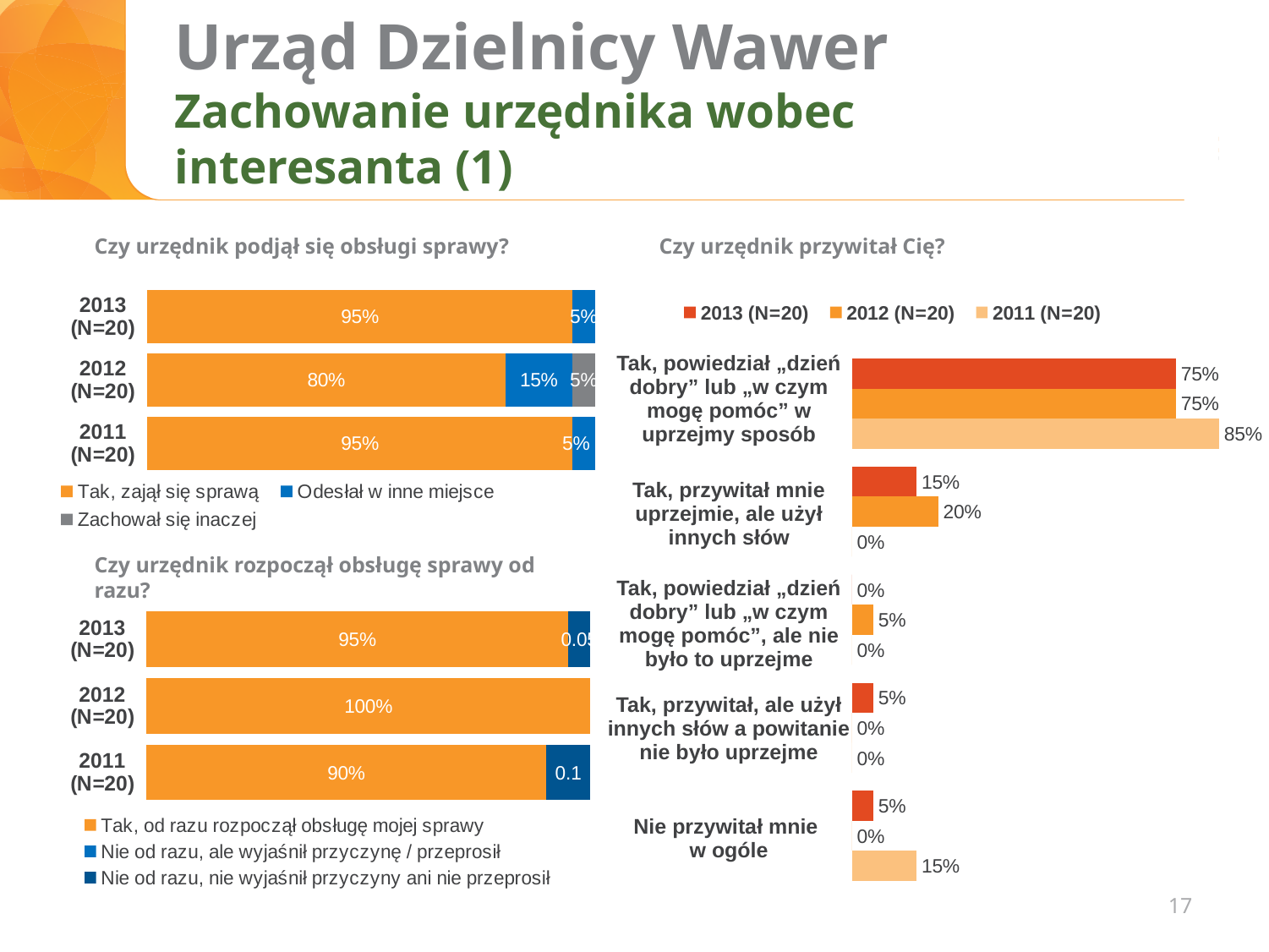
In the chart "Czy urzędnik przywitał Cię?", which is larger for "Nie przywitał mnie w ogóle": the 2013 (N=20) value or the 2011 (N=20) value? 2011 (N=20) In the chart "Czy urzędnik rozpoczął obsługę sprawy od razu?", which year has the highest value for "Tak, od razu rozpoczął obsługę mojej sprawy"? 2012 (N=20) In the chart "Czy urzędnik podjął się obsługi sprawy?", how many series does the legend list? 3 In the chart "Czy urzędnik rozpoczął obsługę sprawy od razu?", what is the value for "Tak, od razu rozpoczął obsługę mojej sprawy" in 2011 (N=20)? 90% In the chart "Czy urzędnik przywitał Cię?", how many categories are shown? 5 In the chart "Czy urzędnik podjął się obsługi sprawy?", which year has the lowest value for "Tak, zajął się sprawą"? 2012 (N=20) In the chart "Czy urzędnik przywitał Cię?", what is the value for 2012 (N=20) in the category "Tak, przywitał mnie uprzejmie, ale użył innych słów"? 20% In the chart "Czy urzędnik przywitał Cię?", what is the difference between the 2011 (N=20) and 2013 (N=20) values for "Tak, powiedział „dzień dobry” lub „w czym mogę pomóc” w uprzejmy sposób"? 10% What kind of chart is "Czy urzędnik rozpoczął obsługę sprawy od razu?"? Stacked bar chart In the chart "Czy urzędnik przywitał Cię?", what is the value for 2011 (N=20) in the category "Tak, powiedział „dzień dobry” lub „w czym mogę pomóc” w uprzejmy sposób"? 85% In the chart "Czy urzędnik podjął się obsługi sprawy?", what is the value for "Odesłał w inne miejsce" in 2012 (N=20)? 15% In the chart "Czy urzędnik podjął się obsługi sprawy?", what is the value for "Tak, zajął się sprawą" in 2012 (N=20)? 80%